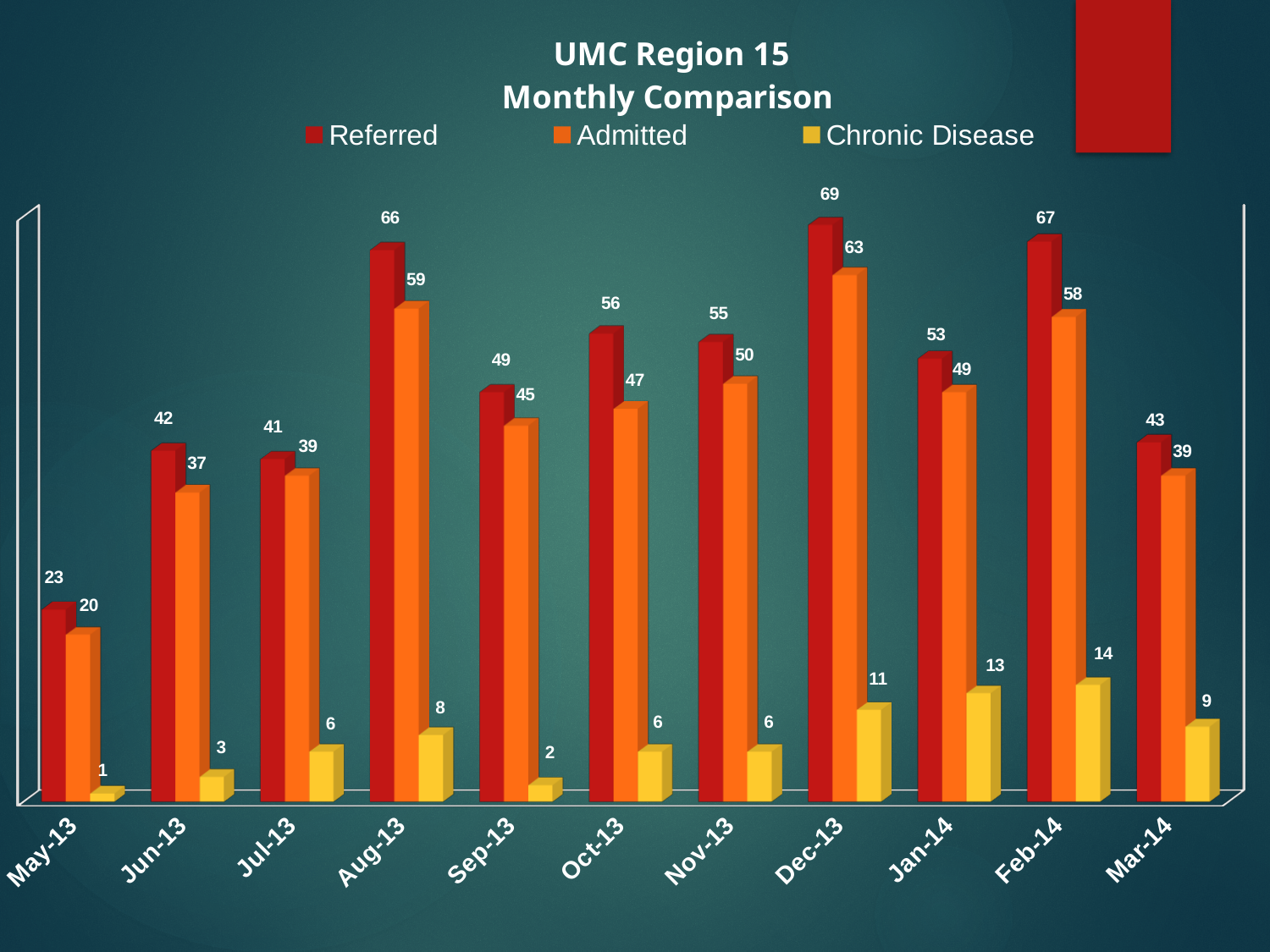
How many months are shown on the x axis? 11 What kind of chart is shown on the slide? Bar chart How many series does the legend list? 3 Which series is shown in yellow? Chronic Disease Which month has the lowest Chronic Disease value? May-13 Which month has the highest Referred value? Dec-13 What is the Chronic Disease value for Feb-14? 14 What is the difference between the Referred and Admitted values for Jun-13? 5 What is the title of the chart? UMC Region 15 Monthly Comparison What is the Admitted value for Aug-13? 59 Which is larger, the Admitted value for Nov-13 or the Admitted value for Jan-14? Nov-13 What is the Referred value for Dec-13? 69